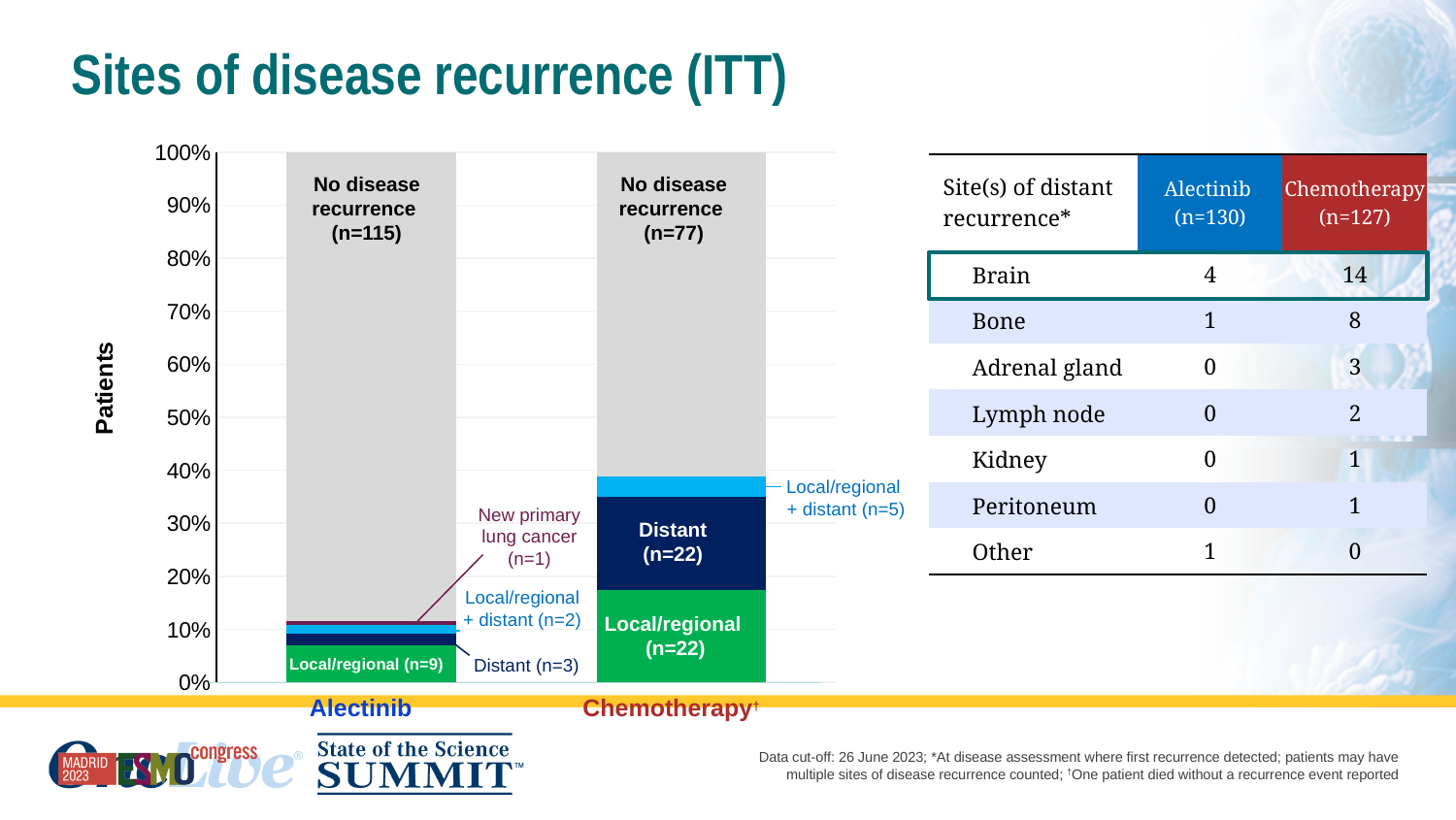
In the chart, how many Chemotherapy patients had distant recurrence? n=22 What is the label on the y-axis of the chart? Patients Which arm had more patients with local/regional recurrence, Alectinib or Chemotherapy? Chemotherapy How many more patients had no disease recurrence in the Alectinib arm than in the Chemotherapy arm? 38 Is the 'Local/regional (n=9)' segment of the Alectinib bar greater or less than 10% of patients? less In the chart, how many Chemotherapy patients had no disease recurrence? n=77 What kind of chart is shown on the slide? Stacked bar chart Is the 'No disease recurrence' segment of the Alectinib bar greater or less than 80% of patients? greater How many treatment groups (bars) are plotted in the chart? 2 What is the total number of patients across all labelled segments of the Alectinib bar? 130 In the chart, how many Alectinib patients had local/regional recurrence? n=9 In the chart, how many Alectinib patients had local/regional + distant recurrence? n=2